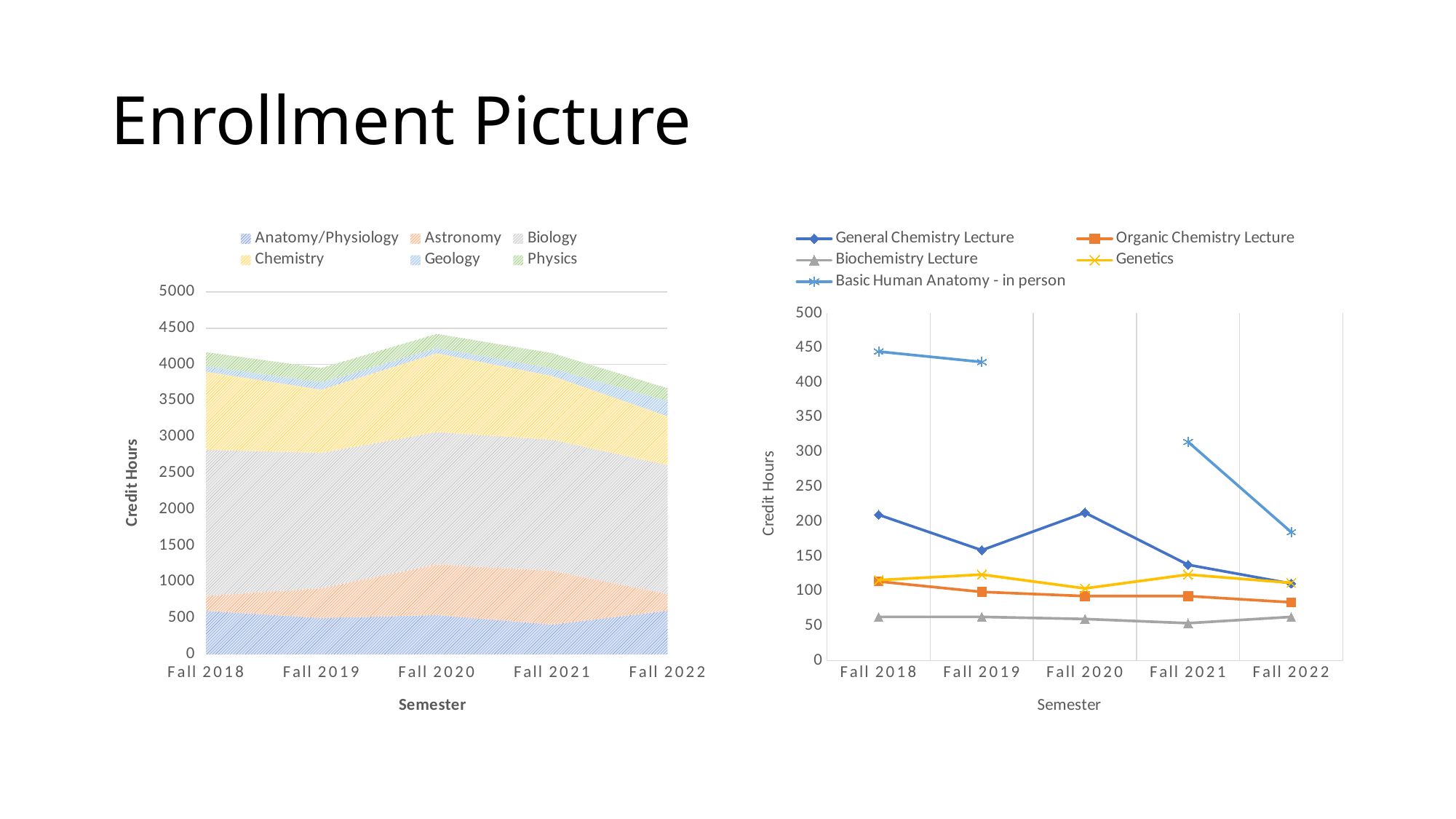
In the right-hand chart, is the value for General Chemistry Lecture in Fall 2019 greater or less than 200? less In the right-hand chart, which is larger in Fall 2020: General Chemistry Lecture or Organic Chemistry Lecture? General Chemistry Lecture How many series does the legend of the left-hand chart list? 6 In the right-hand chart, which series has the highest value in Fall 2018? Basic Human Anatomy - in person In the right-hand chart, does the Organic Chemistry Lecture series rise or fall from Fall 2018 to Fall 2022? fall How many semesters are shown along the x axis of the left-hand chart? 5 In the right-hand chart, which series has the lowest value in Fall 2021? Biochemistry Lecture What kind of chart is the chart on the right of the slide? line chart In the right-hand chart, is the value for Biochemistry Lecture in Fall 2020 greater or less than 100? less In the left-hand chart, is the total stacked value for Fall 2022 greater or less than 4000? less How many series does the legend of the right-hand chart list? 5